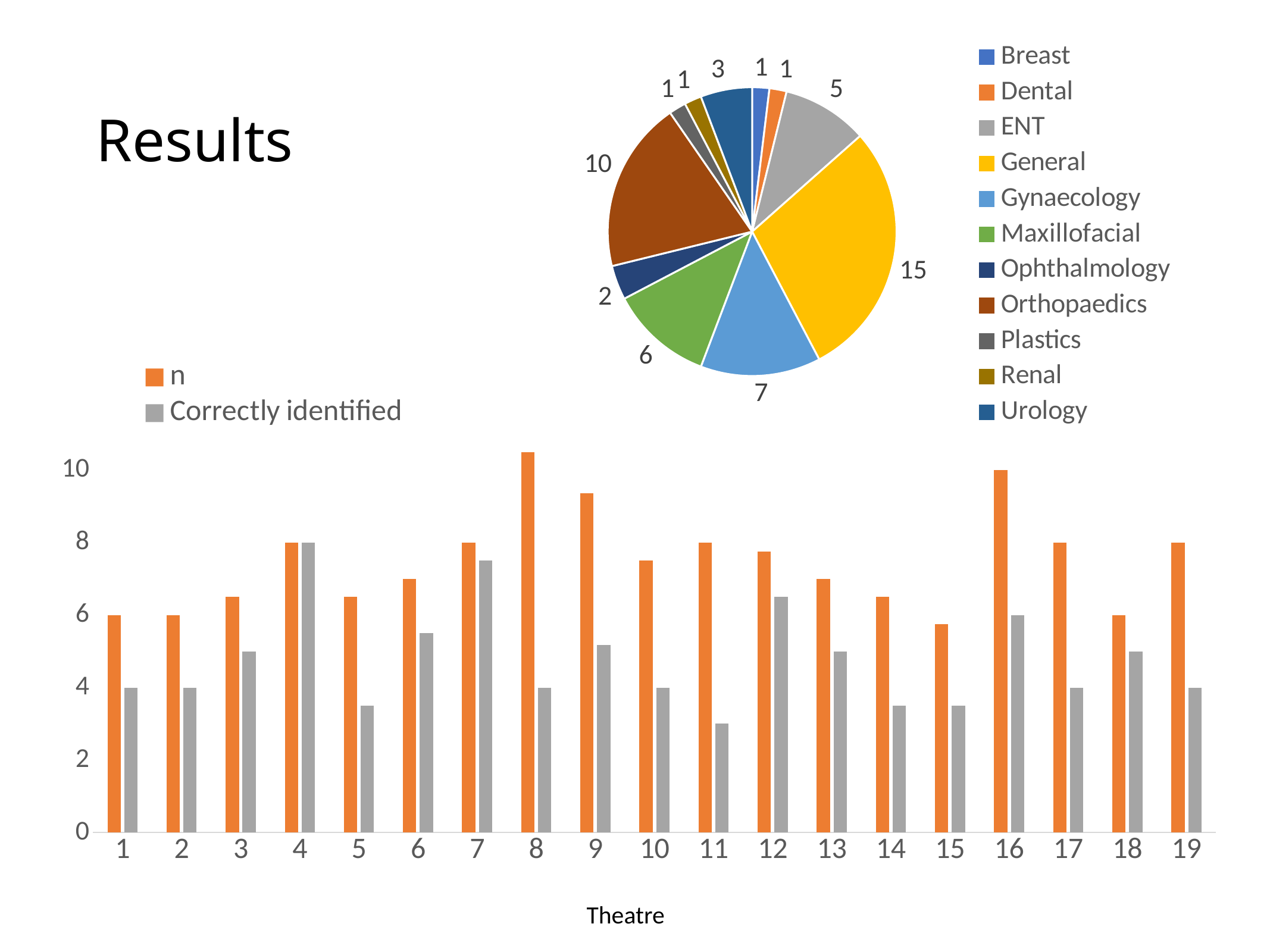
In the pie chart, what is the value for Ophthalmology? 2 How many series does the legend of the bottom bar chart list? 2 In the bottom bar chart, how many theatres are shown on the x axis? 19 In the pie chart, which is larger, the value for ENT or the value for Urology? ENT What kind of chart is the chart at the bottom of the slide? bar chart In the pie chart, what is the difference between the values for Gynaecology and Maxillofacial? 1 In the bottom bar chart, is the Correctly identified value for theatre 11 greater or less than 4? less In the bottom bar chart, is the value of n for theatre 8 greater or less than 10? greater In the pie chart, which category has the largest slice? General In the pie chart, what is the value for General? 15 In the pie chart, what is the value for Orthopaedics? 10 How many categories does the pie chart's legend list? 11